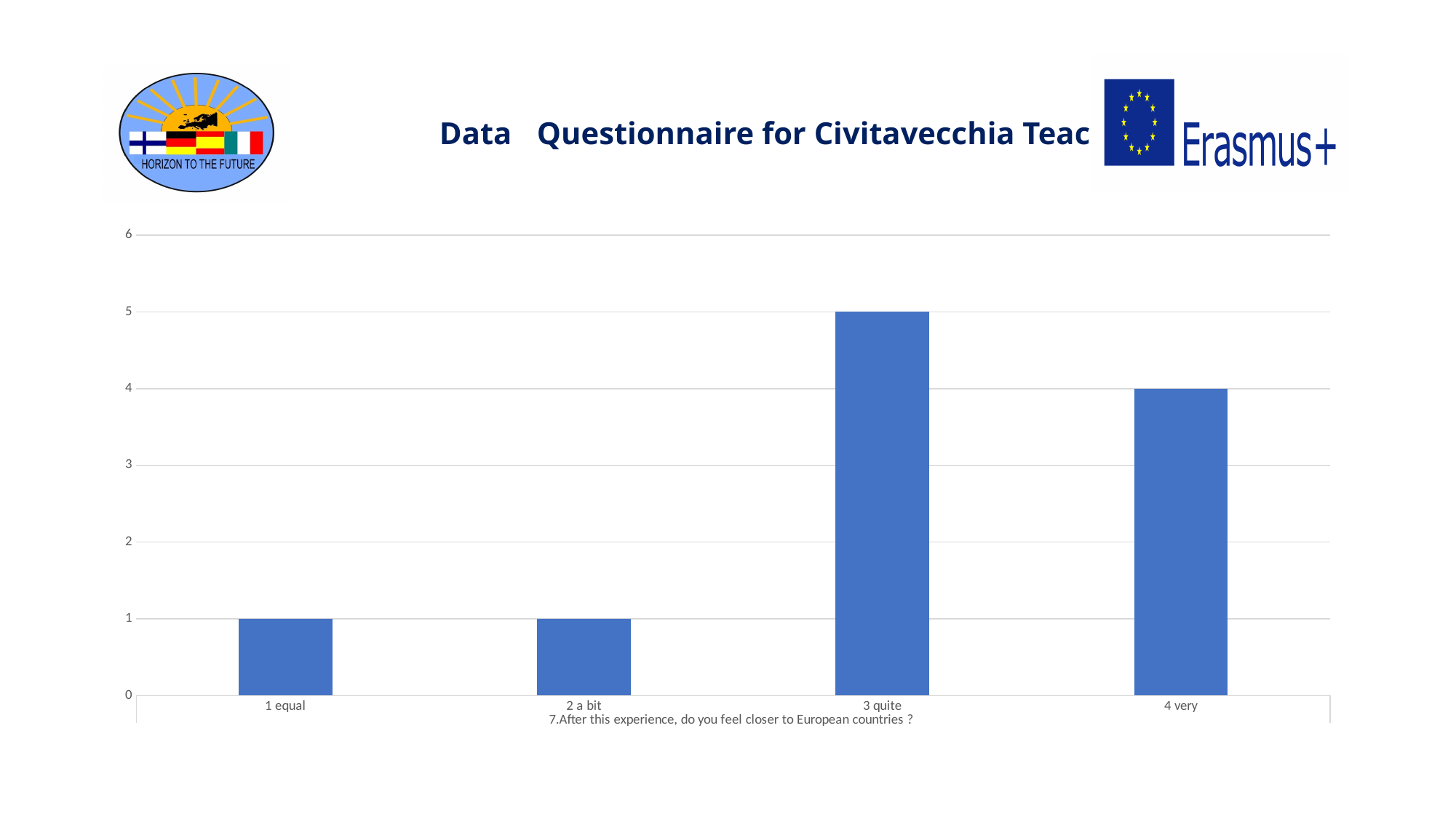
Is the value for "3 quite" greater or less than 3? greater What is the value for "2 a bit"? 1 What is the value for "1 equal"? 1 What is the value for "3 quite"? 5 What type of chart is shown on the slide? bar chart Which category has the highest value? 3 quite What is the difference between the values for "3 quite" and "4 very"? 1 Which is larger, the value for "4 very" or the value for "2 a bit"? 4 very How many categories are shown on the x axis of the chart? 4 What is the difference between the values for "4 very" and "1 equal"? 3 What is the value for "4 very"? 4 What question is written as the x-axis title of the chart? 7.After this experience, do you feel closer to European countries ?